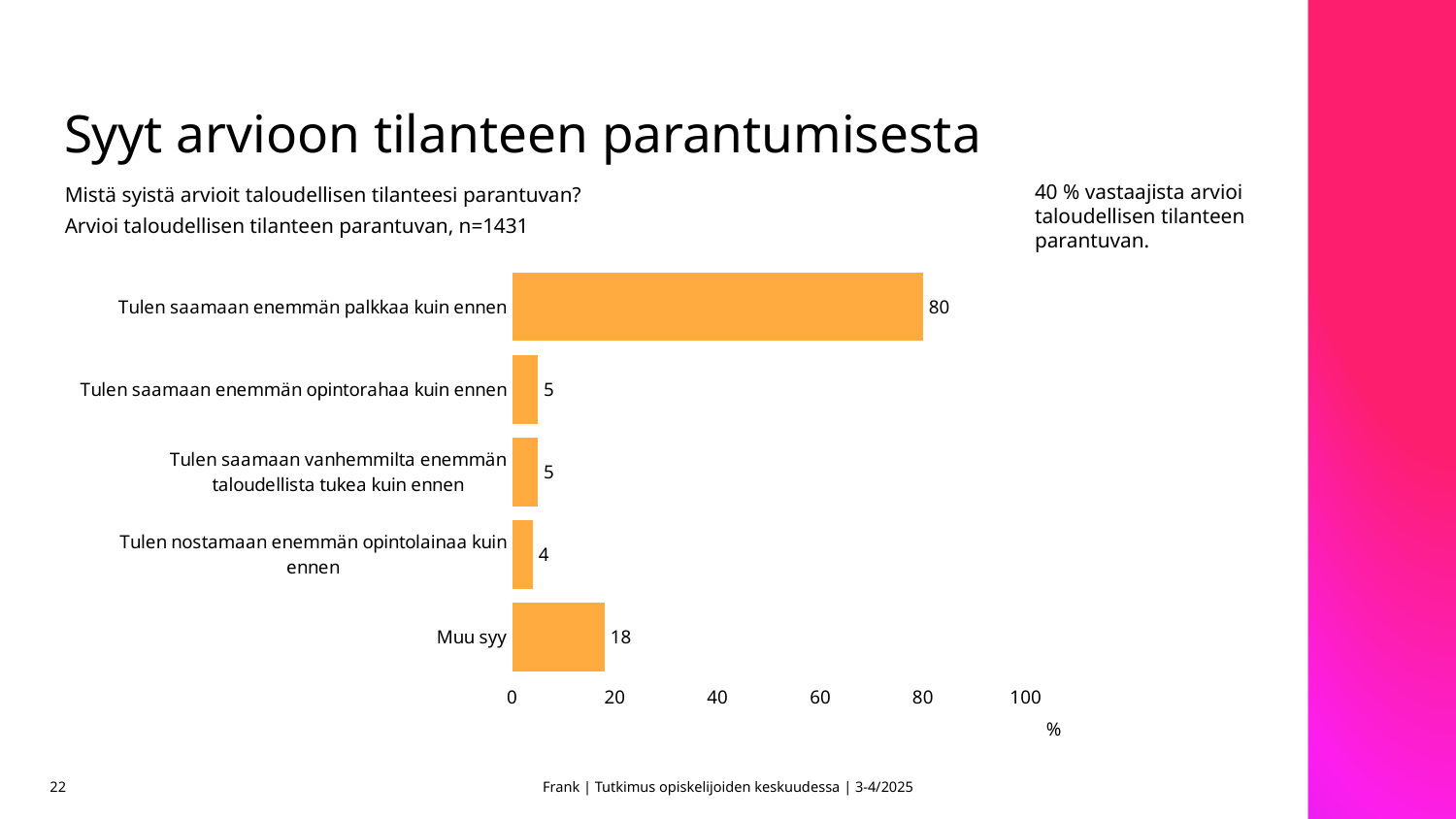
Which category has the lowest value? Tulen nostamaan enemmän opintolainaa kuin ennen What is the sample size (n) stated above the chart? n=1431 What kind of chart is shown on the slide? bar chart What is the value for "Tulen saamaan enemmän palkkaa kuin ennen"? 80 How many categories are shown in the chart? 5 Is the value for "Muu syy" greater or less than 20? less What is the value for "Tulen nostamaan enemmän opintolainaa kuin ennen"? 4 Which is larger, the value for "Muu syy" or the value for "Tulen saamaan vanhemmilta enemmän taloudellista tukea kuin ennen"? Muu syy What is the value for "Tulen saamaan enemmän opintorahaa kuin ennen"? 5 What is the difference between the values for "Tulen saamaan enemmän palkkaa kuin ennen" and "Muu syy"? 62 What is the value for "Muu syy"? 18 Which category has the highest value? Tulen saamaan enemmän palkkaa kuin ennen